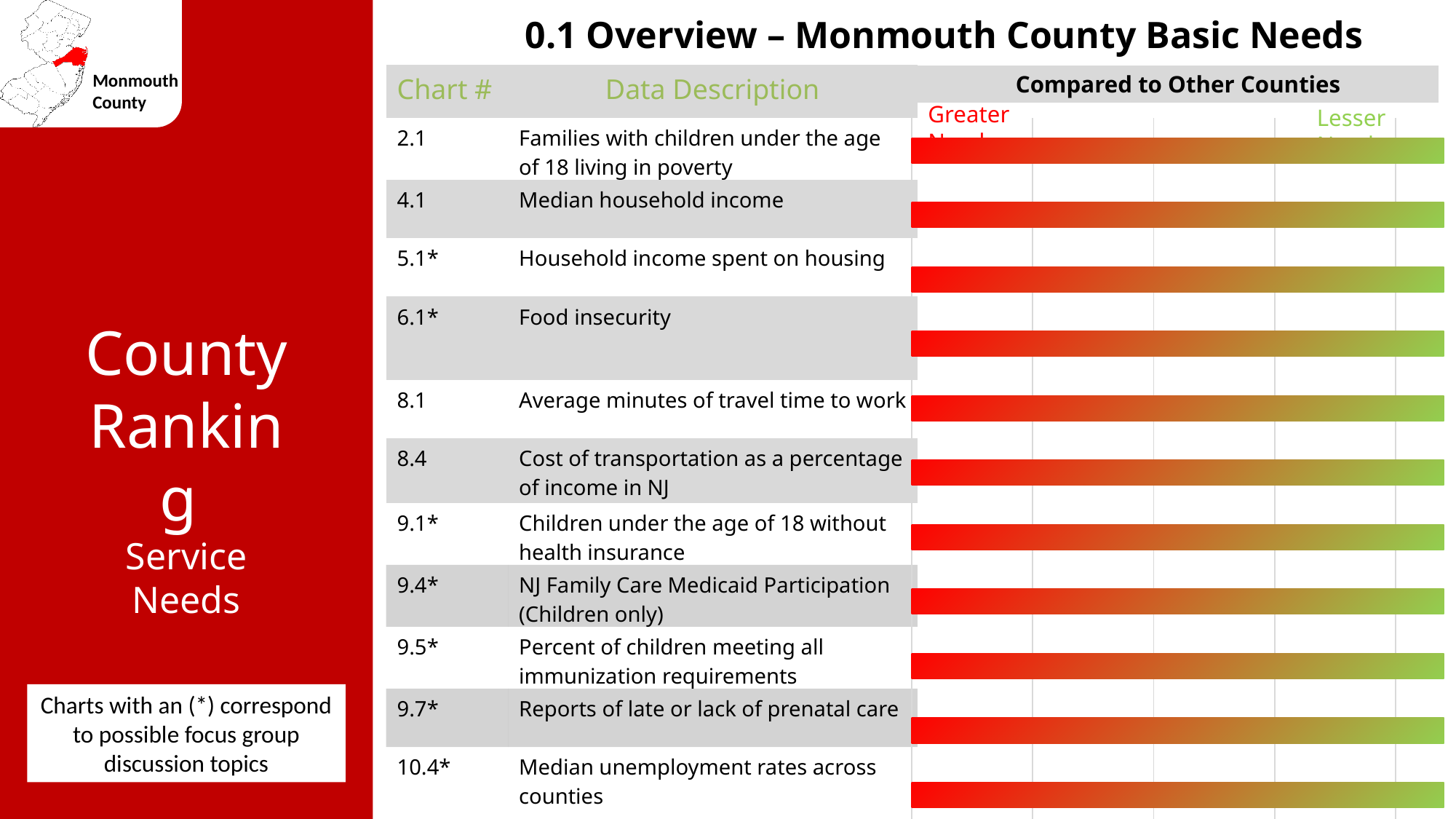
What data description is listed for chart number 10.4*? Median unemployment rates across counties What is the heading above the bars on the right side of the table? Compared to Other Counties How many of the listed chart numbers are marked with an asterisk (*)? 7 Which chart number corresponds to 'Median household income'? 4.1 How many data description rows (bars) are shown in the chart? 11 What kind of chart is used to show how Monmouth County compares to other counties? bar chart Which chart number corresponds to the data description 'Food insecurity'? 6.1* What data description is listed for chart number 8.1? Average minutes of travel time to work What is the title of the slide containing the chart? 0.1 Overview – Monmouth County Basic Needs